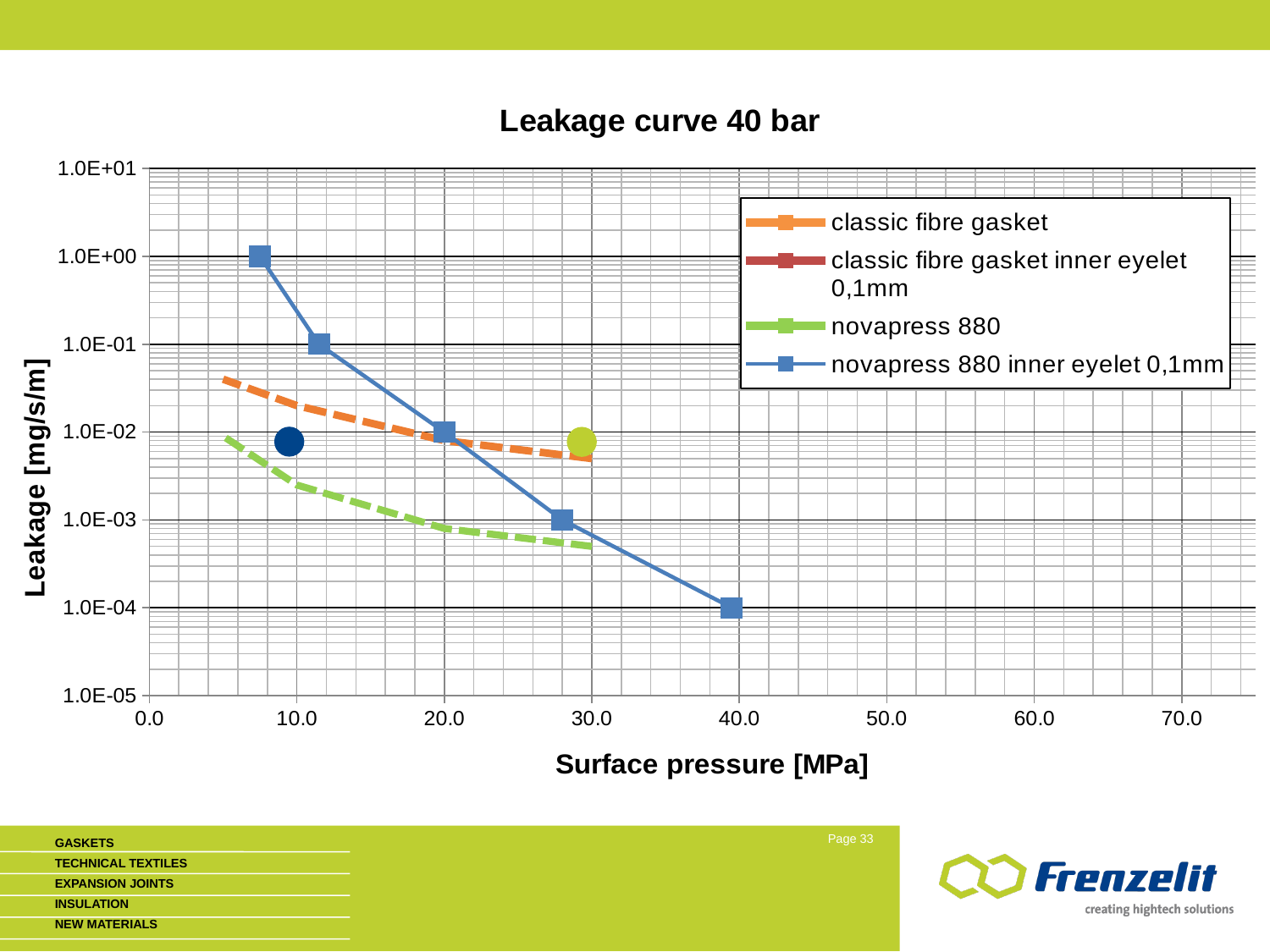
Which series reaches the lowest leakage value on the chart? novapress 880 inner eyelet 0,1mm What is the highest leakage value reached by the novapress 880 inner eyelet 0,1mm series? 1.0E+00 At 20.0 MPa, which series has the higher leakage: classic fibre gasket or novapress 880? classic fibre gasket What is the label of the x axis? Surface pressure [MPa] Is the leakage of the classic fibre gasket at 10.0 MPa greater or less than 1.0E-02? greater What is the lowest leakage value reached by the novapress 880 inner eyelet 0,1mm series? 1.0E-04 How many series does the legend list? 4 How many data points (square markers) are plotted for the novapress 880 inner eyelet 0,1mm series? 5 What kind of chart is shown on the slide? line chart What is the title of the chart? Leakage curve 40 bar Is the leakage of novapress 880 at 30.0 MPa greater or less than 1.0E-03? less Does leakage rise or fall as surface pressure increases along the x axis? fall